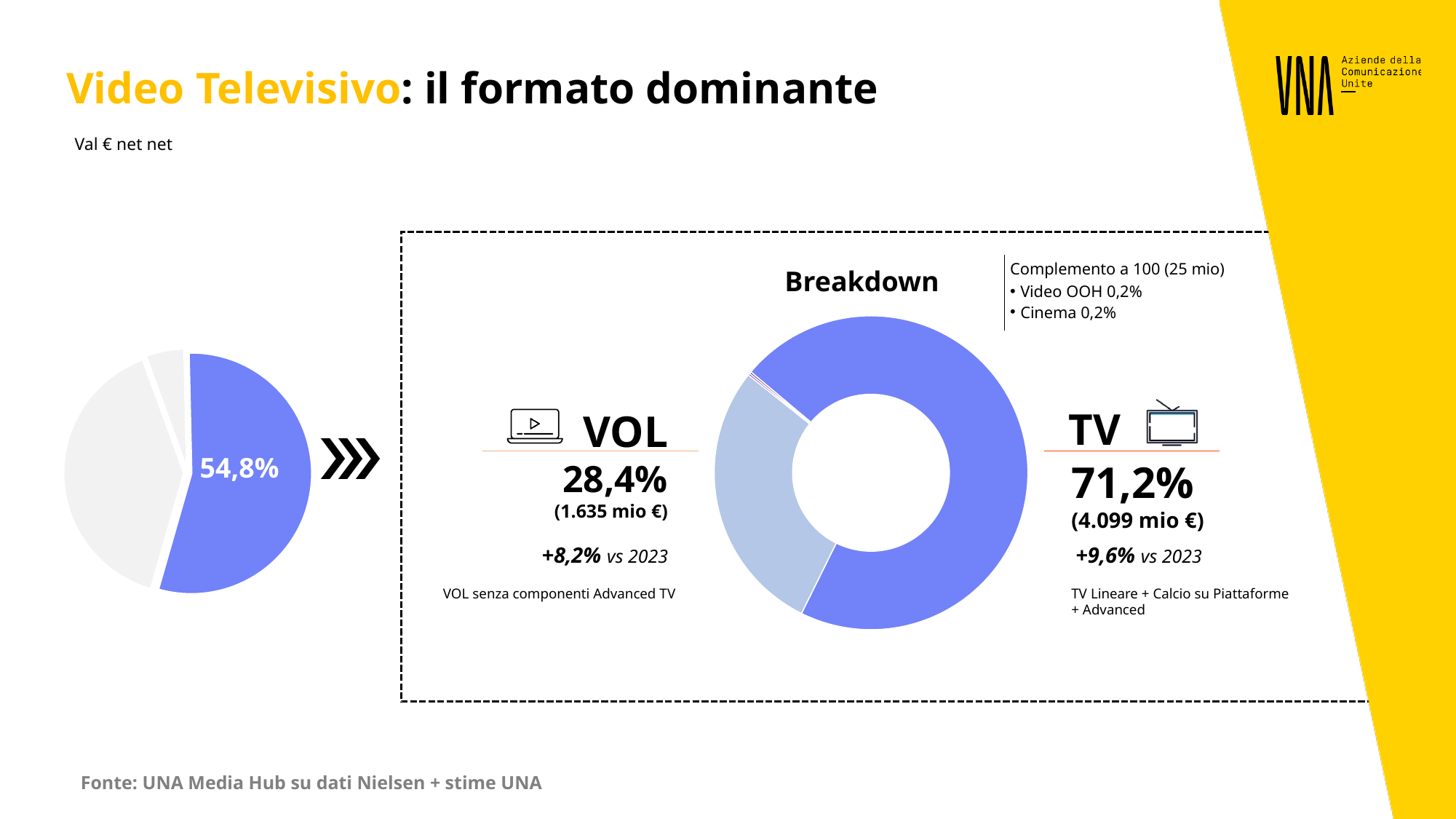
In the Breakdown donut chart, what is the growth of TV vs 2023? +9,6% In the Breakdown donut chart, what share does Cinema hold according to the note? 0,2% In the Breakdown donut chart, what share does TV hold? 71,2% In the Breakdown donut chart, what share does VOL hold? 28,4% In the pie chart on the left, what percentage is shown on the highlighted blue slice? 54,8% What kind of chart is the Breakdown chart on the right? Donut chart In the Breakdown donut chart, which is larger, TV or VOL? TV In the Breakdown donut chart, what is the value in mio € for VOL? 1.635 mio € In the Breakdown donut chart, which segment is the largest? TV In the Breakdown donut chart, what is the growth of VOL vs 2023? +8,2% In the Breakdown donut chart, what is the value in mio € for TV? 4.099 mio € In the Breakdown donut chart, what is the difference in percentage points between the TV share and the VOL share? 42,8